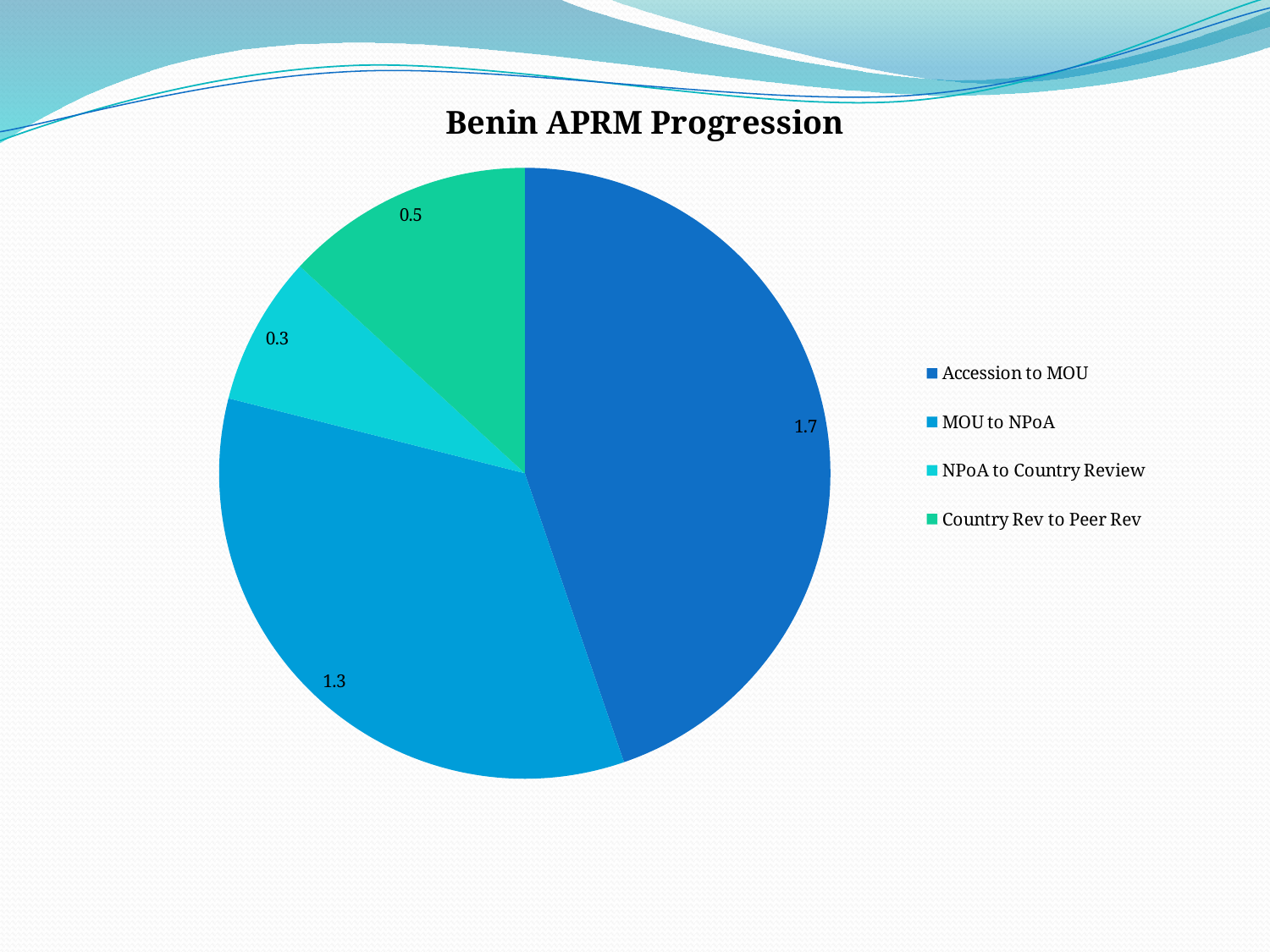
What is the value for MOU to NPoA? 1.3 What is the difference between the values for Accession to MOU and MOU to NPoA? 0.4 What is the value for Accession to MOU? 1.7 What is the difference between the values for Country Rev to Peer Rev and NPoA to Country Review? 0.2 Which category has the smallest slice of the pie? NPoA to Country Review What is the title of the chart? Benin APRM Progression What is the value for Country Rev to Peer Rev? 0.5 What kind of chart is shown on the slide? Pie chart What is the value for NPoA to Country Review? 0.3 How many categories does the pie chart show? 4 Which category has the largest slice of the pie? Accession to MOU Which is larger, the value for MOU to NPoA or the value for Country Rev to Peer Rev? MOU to NPoA